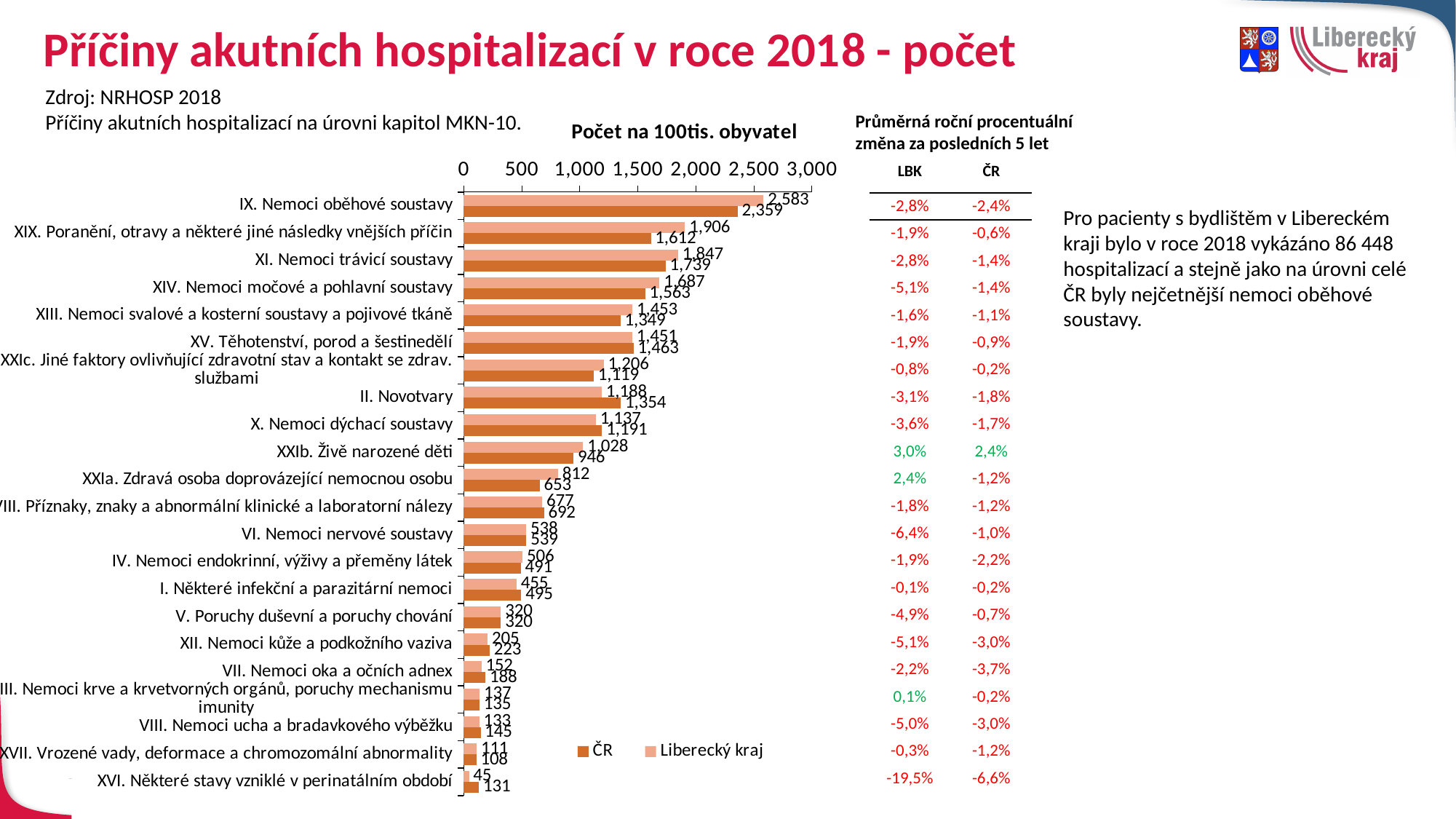
For 'XVI. Některé stavy vzniklé v perinatálním období', which series has the larger value, ČR or Liberecký kraj? ČR What is the value for ČR for 'II. Novotvary'? 1,354 How many series does the legend of the bar chart list? 2 What type of chart is used to show the number of acute hospitalisations per 100 thousand inhabitants? bar chart Which category has the highest value for Liberecký kraj? IX. Nemoci oběhové soustavy What is the title of the bar chart? Počet na 100tis. obyvatel What is the difference between the Liberecký kraj and ČR values for 'IX. Nemoci oběhové soustavy'? 224 Which category has the lowest value for Liberecký kraj? XVI. Některé stavy vzniklé v perinatálním období What is the value for Liberecký kraj for 'IX. Nemoci oběhové soustavy'? 2,583 How many categories (MKN-10 chapters) are shown in the bar chart? 22 What is the value for ČR for 'XIX. Poranění, otravy a některé jiné následky vnějších příčin'? 1,612 What is the value for Liberecký kraj for 'XXIb. Živě narozené děti'? 1,028